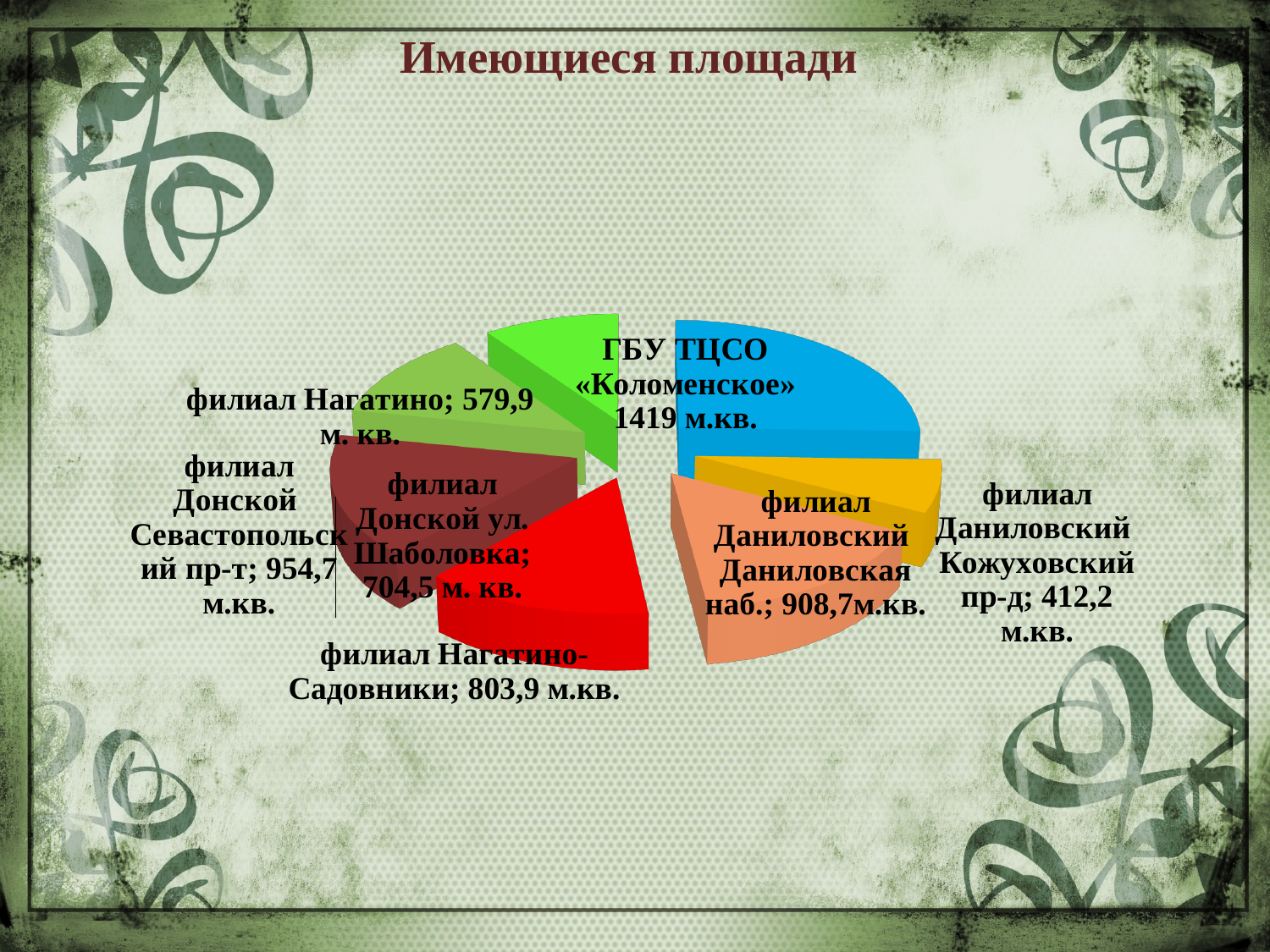
What is the area for филиал Нагатино-Садовники? 803,9 м.кв. What is the area for ГБУ ТЦСО «Коломенское»? 1419 м.кв. Which slice has the largest area? ГБУ ТЦСО «Коломенское» What is the title of the chart? Имеющиеся площади What is the difference between the areas of ГБУ ТЦСО «Коломенское» and филиал Даниловский Кожуховский пр-д? 1006,8 м.кв. What kind of chart is shown on the slide? Pie chart What is the area for филиал Даниловский Кожуховский пр-д? 412,2 м.кв. What colour is the slice for ГБУ ТЦСО «Коломенское»? Blue Which is larger: филиал Донской Севастопольский пр-т or филиал Нагатино? филиал Донской Севастопольский пр-т Which slice has the smallest area? филиал Даниловский Кожуховский пр-д What is the area for филиал Донской ул. Шаболовка? 704,5 м. кв. How many slices does the pie chart have? 7